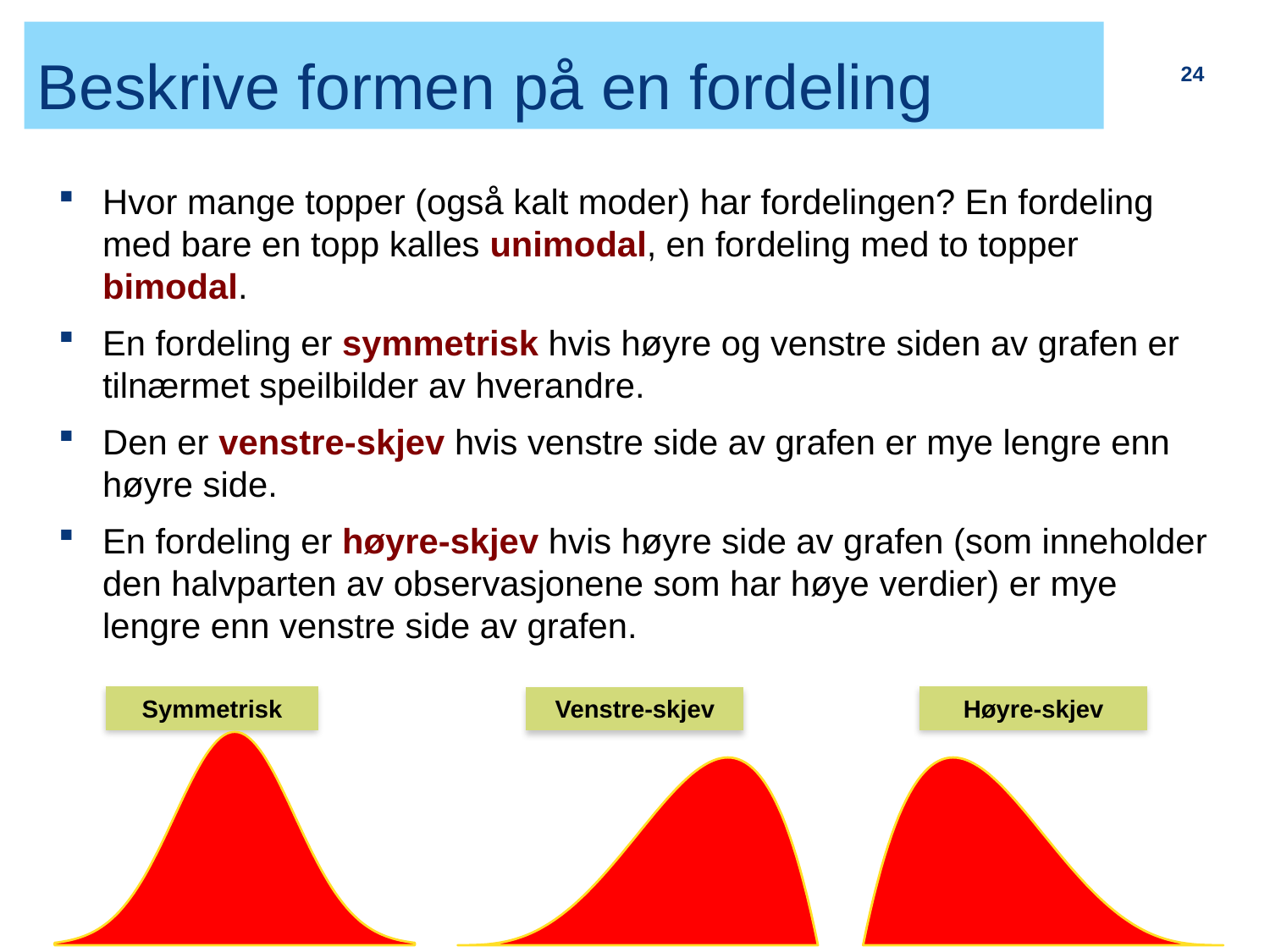
How many distribution curves are shown at the bottom of the slide? 3 What fill colour is used for the curves in all three charts? red In the Høyre-skjev chart, is the peak located on the left side or the right side of the curve? left side In the Høyre-skjev chart, does the curve rise or fall as you move to the right of its peak? fall What kind of chart is the leftmost chart labelled Symmetrisk? area chart What is the label above the middle chart? Venstre-skjev In the Venstre-skjev chart, does the curve mostly rise or fall as you move from left to right before reaching its peak? rise In the Venstre-skjev chart, is the peak located on the left side or the right side of the curve? right side